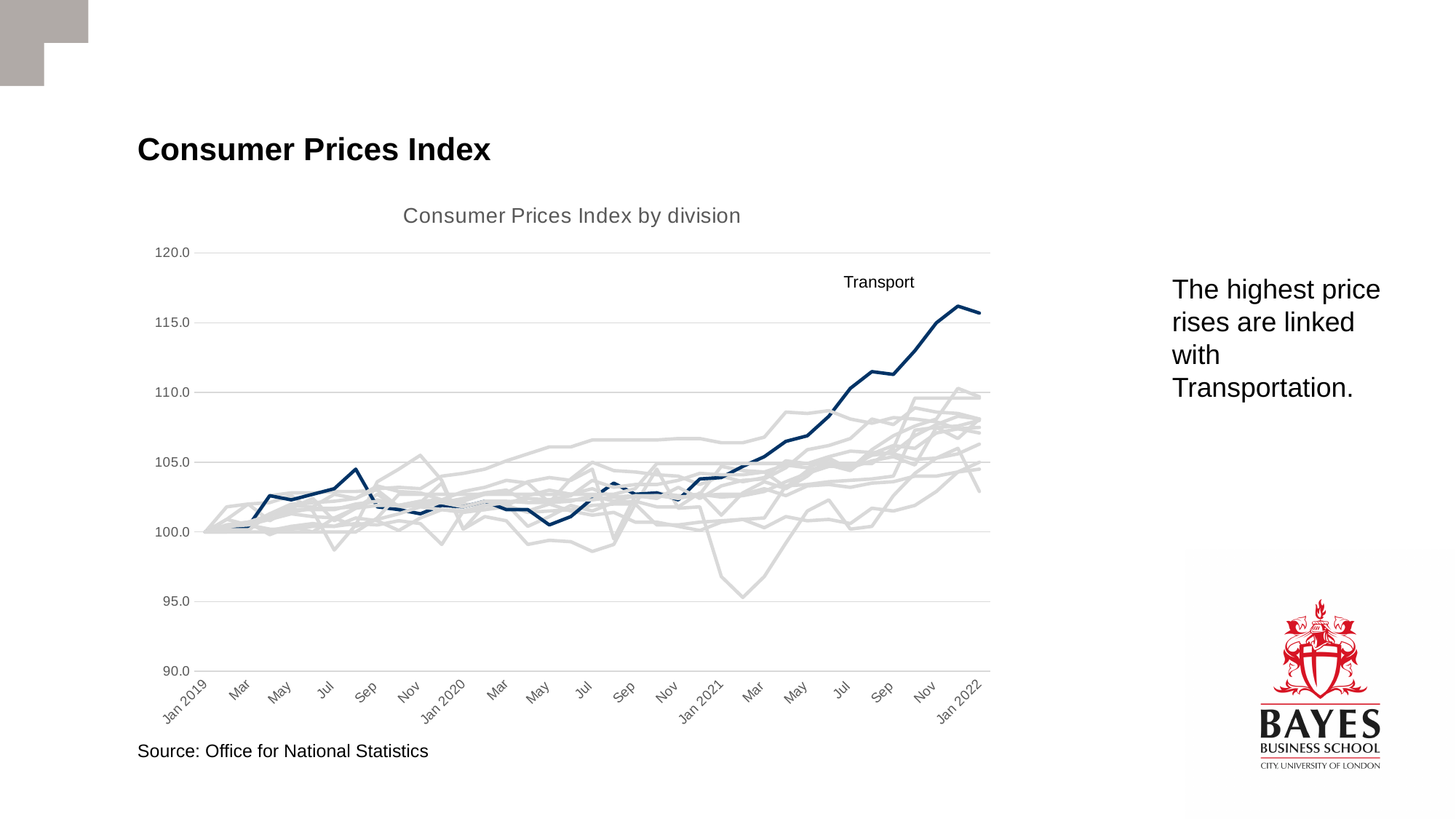
Is the value of the Transport series in Jan 2021 greater or less than 105? less What is the title of the chart? Consumer Prices Index by division What type of chart is shown on the slide? Line chart Is the value of the Transport series in Sep 2021 greater or less than 110? greater Is the value of the Transport series in Jan 2020 greater or less than 105? less What is the lowest value shown on the vertical axis? 90.0 Which series is highlighted in dark blue and labelled on the chart? Transport Which is larger for the Transport series: the value in Jan 2022 or the value in Jan 2021? Jan 2022 What is the value of the Transport series in Jan 2019? 100.0 Does the Transport series rise or fall overall from Jan 2019 to Jan 2022? rise What is the highest value shown on the vertical axis? 120.0